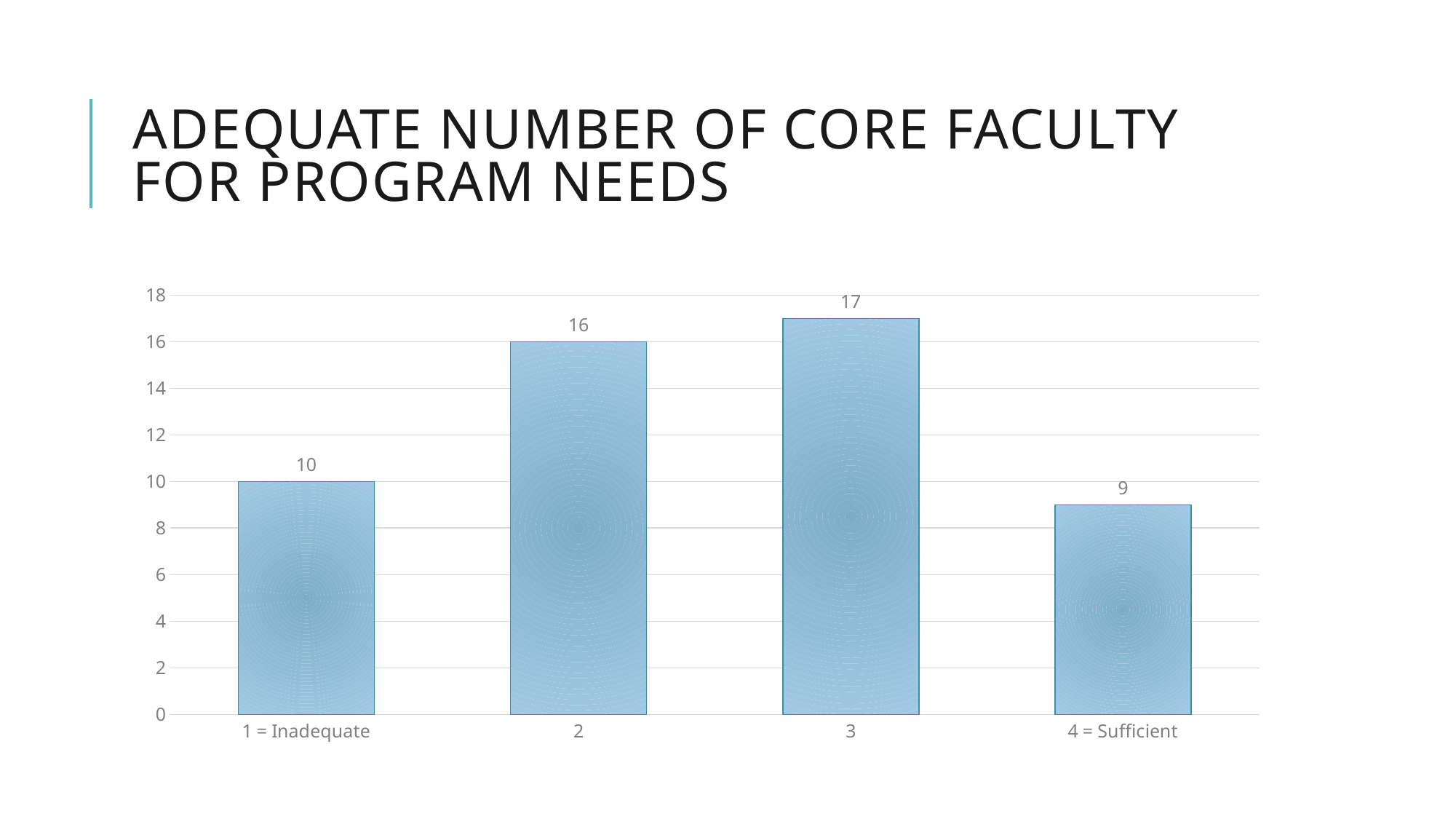
Which is larger, the value for "1 = Inadequate" or the value for "4 = Sufficient"? 1 = Inadequate Which category has the highest value? 3 What is the value for the category "1 = Inadequate"? 10 Is the value for category "2" greater or less than 12? greater Which category has the lowest value? 4 = Sufficient What is the value for category "2"? 16 What is the difference between the values for category "3" and category "1 = Inadequate"? 7 What is the title of the slide containing the chart? Adequate Number of Core Faculty for Program Needs What kind of chart is shown on the slide? bar chart How many categories are shown on the x axis? 4 What is the value for the category "4 = Sufficient"? 9 What is the value for category "3"? 17